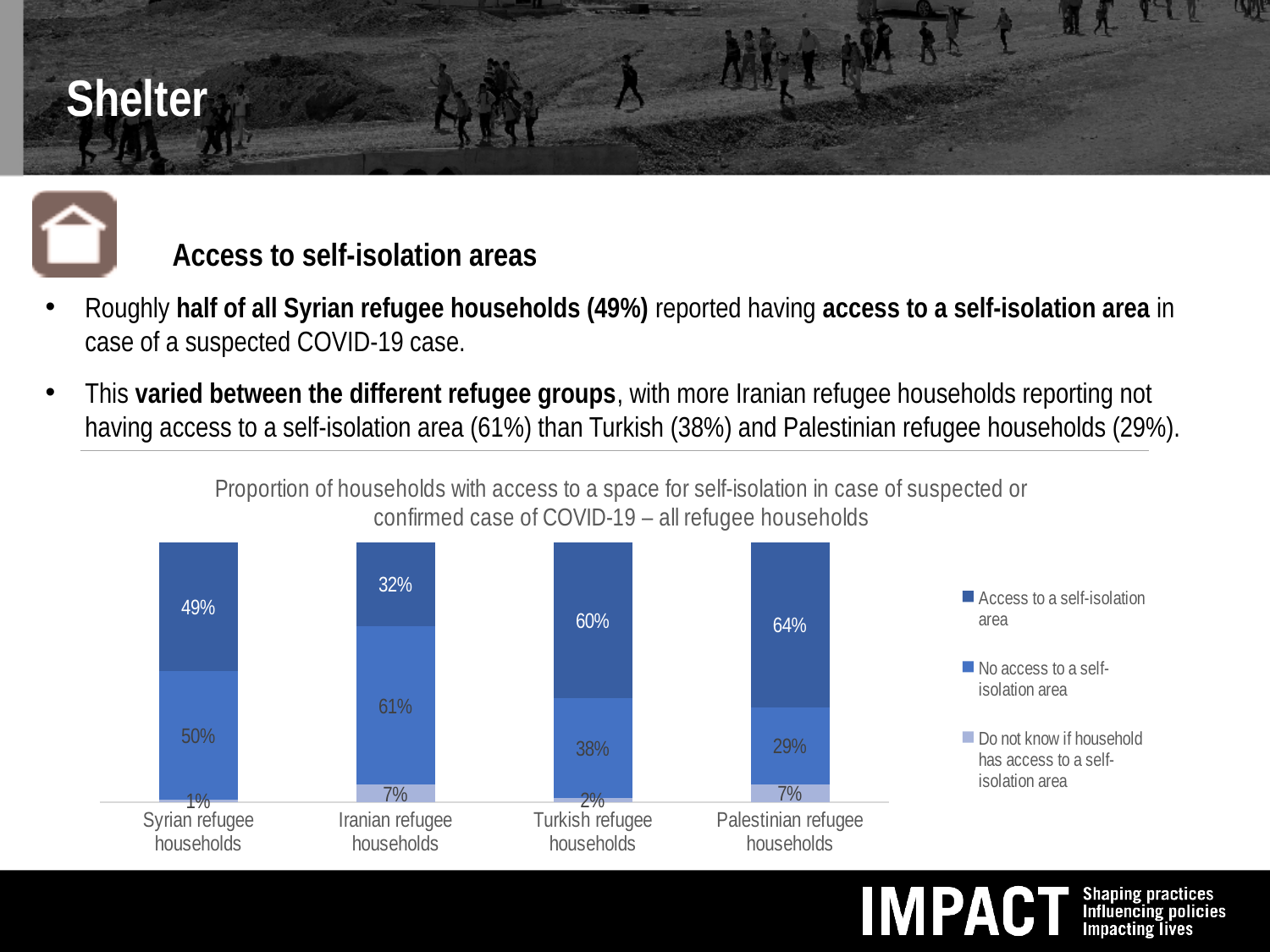
What percentage of Syrian refugee households reported having access to a self-isolation area? 49% Which refugee group has the lowest proportion of households with access to a self-isolation area? Iranian refugee households What percentage of Palestinian refugee households did not know if the household has access to a self-isolation area? 7% How many refugee groups are shown on the x axis of the chart? 4 What is the total of the three segments in the Turkish refugee households bar? 100% Which legend entry is represented by the darkest blue colour in the chart? Access to a self-isolation area How many series does the chart legend list? 3 What is the difference between the share of Turkish refugee households with access to a self-isolation area and the share with no access? 22% What kind of chart is shown on the slide? Stacked bar chart What percentage of Iranian refugee households reported no access to a self-isolation area? 61% Which is larger: the share of Iranian refugee households with no access to a self-isolation area or the share of Syrian refugee households with no access? Iranian refugee households Which refugee group has the highest proportion of households with access to a self-isolation area? Palestinian refugee households